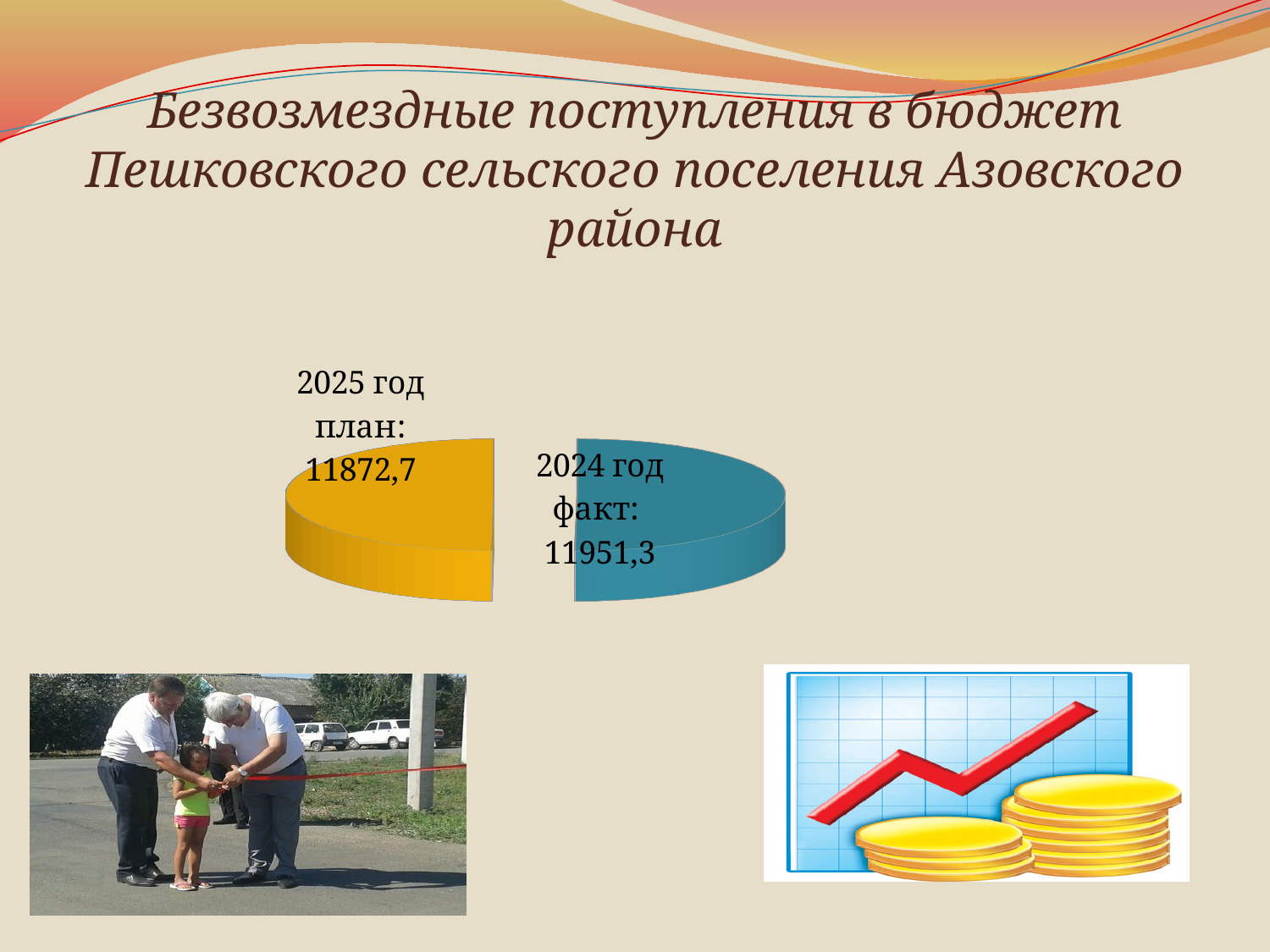
Which slice of the pie chart has the smaller value? 2025 год план How many slices does the pie chart have? 2 What colour is the 2025 год план slice of the pie chart? Yellow What is the value shown for the 2024 год факт slice of the pie chart? 11951,3 Is the value for 2025 год план larger or smaller than the value for 2024 год факт? Smaller What kind of chart is shown on the slide? Pie chart What is the total of the two values shown in the pie chart? 23824,0 What is the difference between the 2024 год факт value and the 2025 год план value? 78,6 What is the value shown for the 2025 год план slice of the pie chart? 11872,7 What is the title of the slide containing the pie chart? Безвозмездные поступления в бюджет Пешковского сельского поселения Азовского района Which slice of the pie chart has the larger value? 2024 год факт